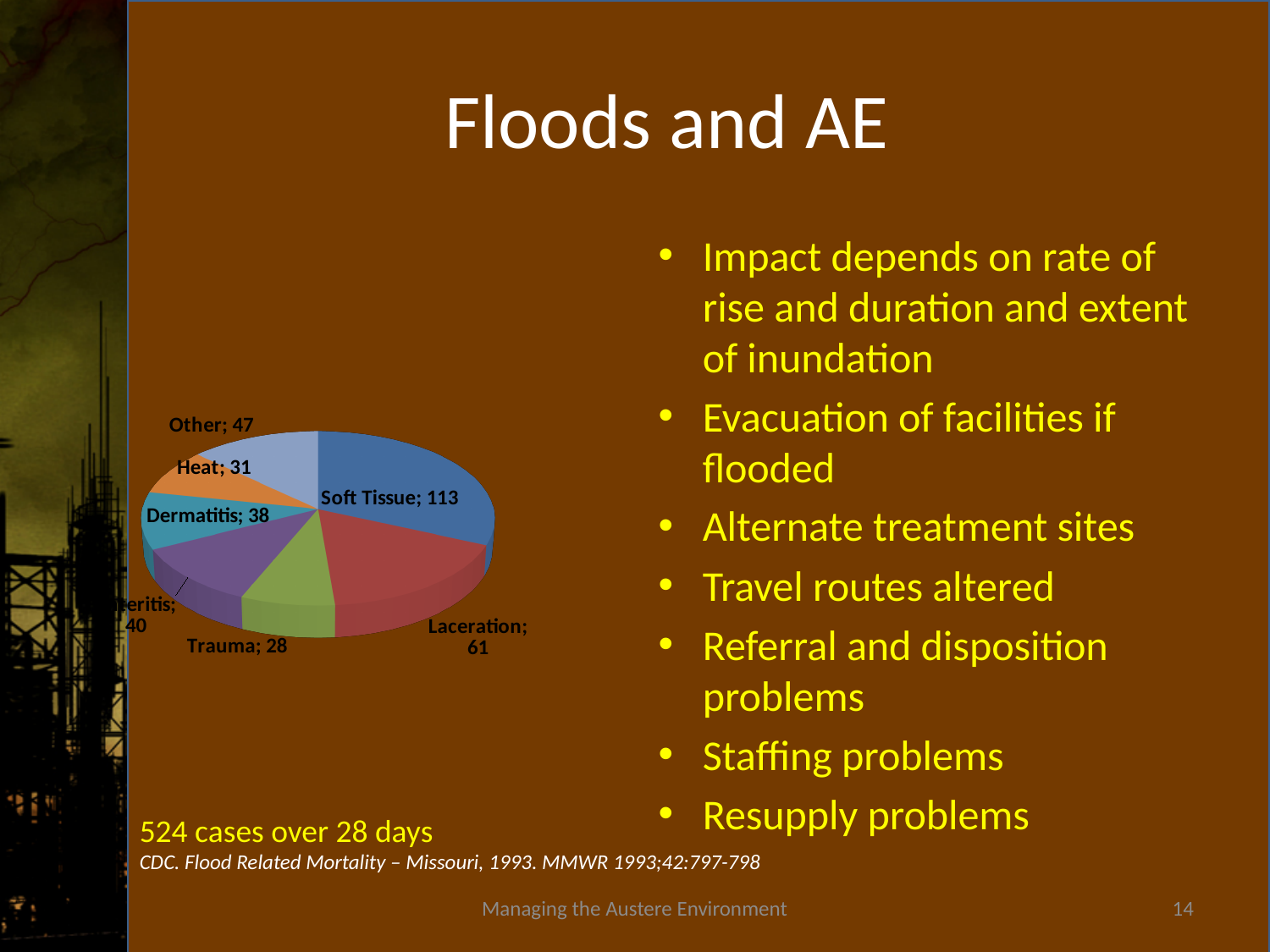
What is the difference between the values for Soft Tissue and Laceration? 52 What is the value for Heat in the pie chart? 31 What is the value for Dermatitis in the pie chart? 38 What is the value for Soft Tissue in the pie chart? 113 Which is larger, the value for Dermatitis or the value for Heat? Dermatitis Which category has the smallest slice in the pie chart? Trauma How many slices does the pie chart have? 7 What is the value for Laceration in the pie chart? 61 What kind of chart is shown on the slide? pie chart What is the value for Other in the pie chart? 47 Which category has the largest slice in the pie chart? Soft Tissue What is the value for Trauma in the pie chart? 28